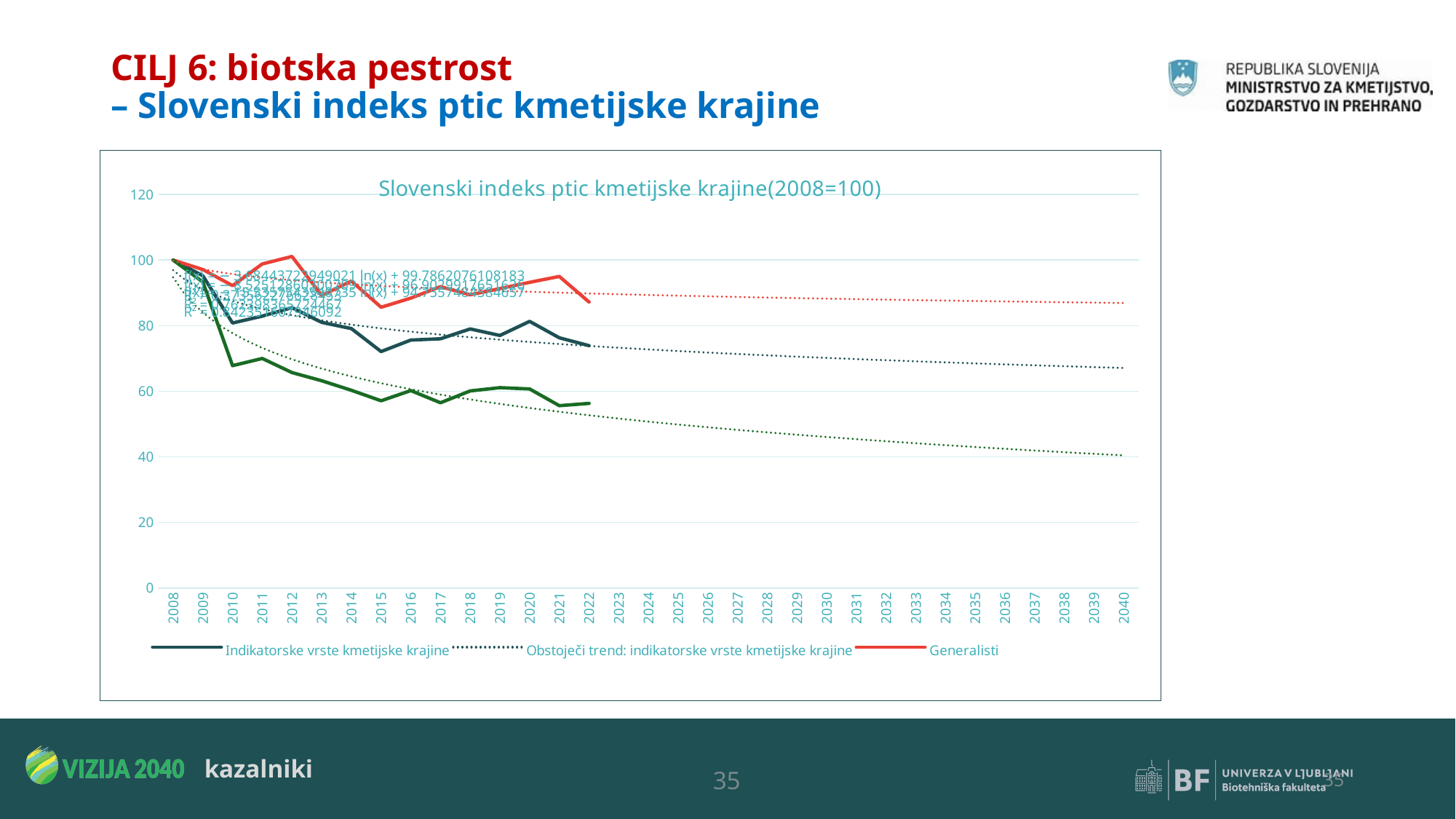
Is the value for Indikatorske vrste kmetijske krajine in 2015 greater or less than 80? less How many series does the chart legend list? 3 In 2022, which series has the higher value: Generalisti or Indikatorske vrste kmetijske krajine? Generalisti What is the last year shown on the x axis? 2040 What kind of chart is shown on the slide? line chart Is the value for Generalisti in 2022 greater or less than 80? greater Does the Indikatorske vrste kmetijske krajine series rise or fall overall from 2008 to 2022? fall What is the title of the chart? Slovenski indeks ptic kmetijske krajine(2008=100) What is the value of the index in 2008? 100 How many years are shown on the x axis of the chart? 33 Is the value for Indikatorske vrste kmetijske krajine in 2022 greater or less than 80? less